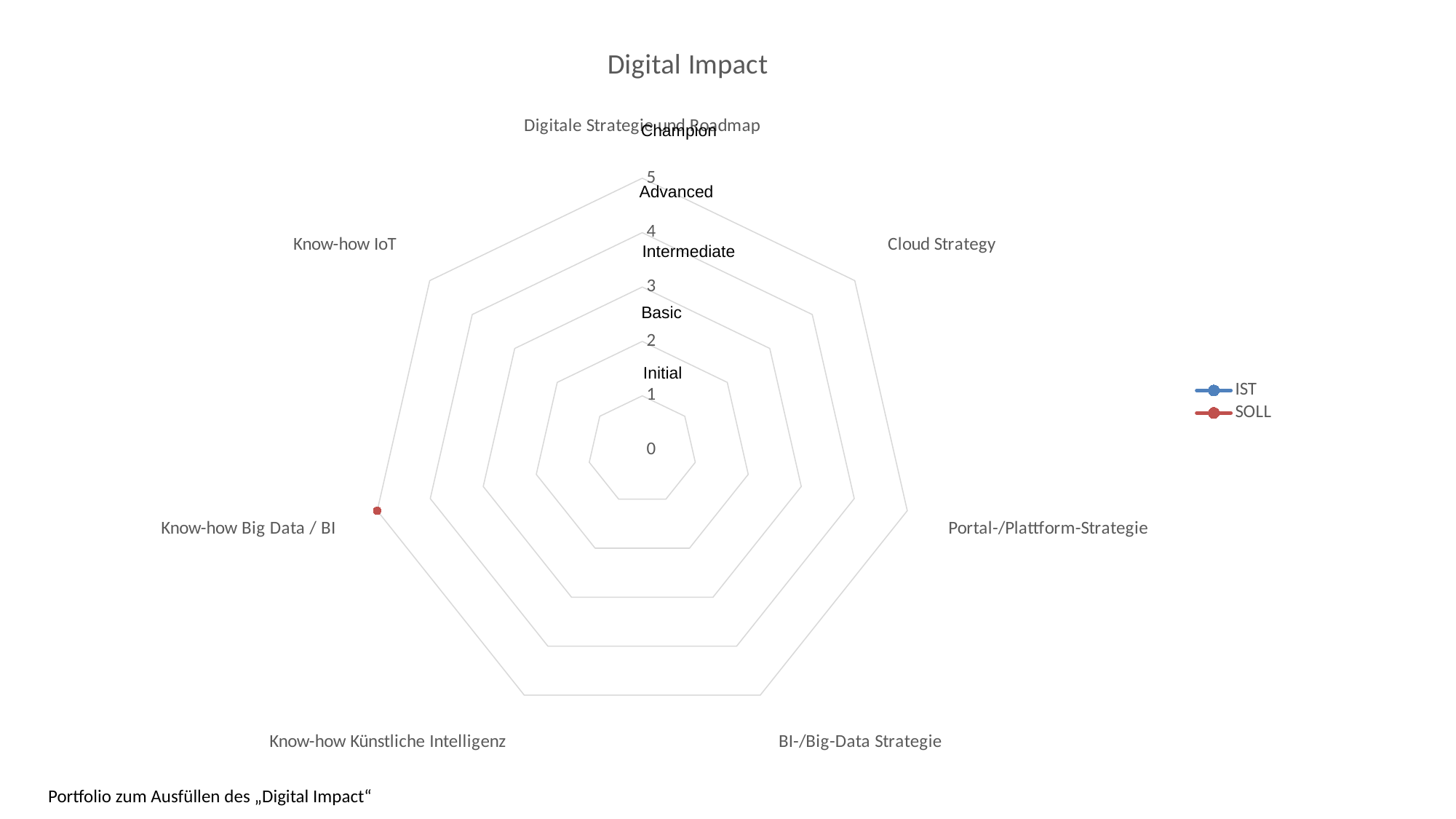
What kind of chart is shown on the slide? Radar chart What is the highest value shown on the chart's axis scale? 5 How many series does the legend list? 2 Which series has a data point plotted on the chart? SOLL Which maturity level label corresponds to the value 1 on the axis? Initial What is the title of the chart? Digital Impact Is the SOLL value for Know-how Big Data / BI greater or less than 4? greater Which series are listed in the legend? IST and SOLL For which category is a SOLL data point plotted? Know-how Big Data / BI How many categories (axes) does the radar chart have? 7 Which maturity level label corresponds to the outermost ring of the chart? Champion What is the SOLL value for Know-how Big Data / BI? 5